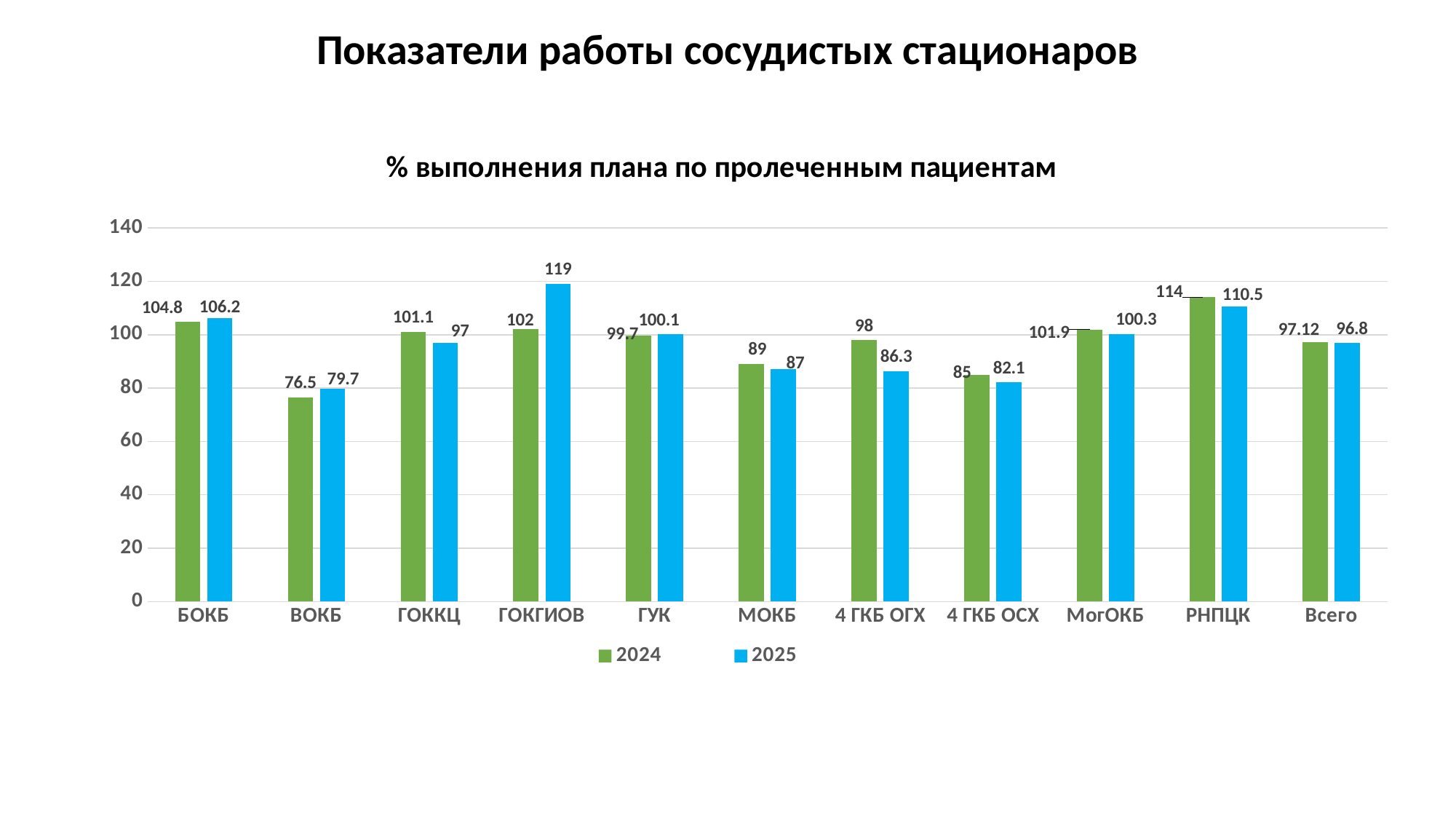
How many series does the legend list? 2 What is the chart's title? % выполнения плана по пролеченным пациентам What is the 2025 value for ГОКГИОВ? 119 Which category has the highest 2025 value? ГОКГИОВ What kind of chart is shown? bar chart What is the 2024 value for ВОКБ? 76.5 Which category has the lowest 2024 value? ВОКБ Which is larger for 4 ГКБ ОГХ, the 2024 value or the 2025 value? 2024 How many categories are shown on the x axis? 11 What is the difference between the 2024 and 2025 values for РНПЦК? 3.5 What is the 2024 value for Всего? 97.12 Which colour represents the 2025 series? blue